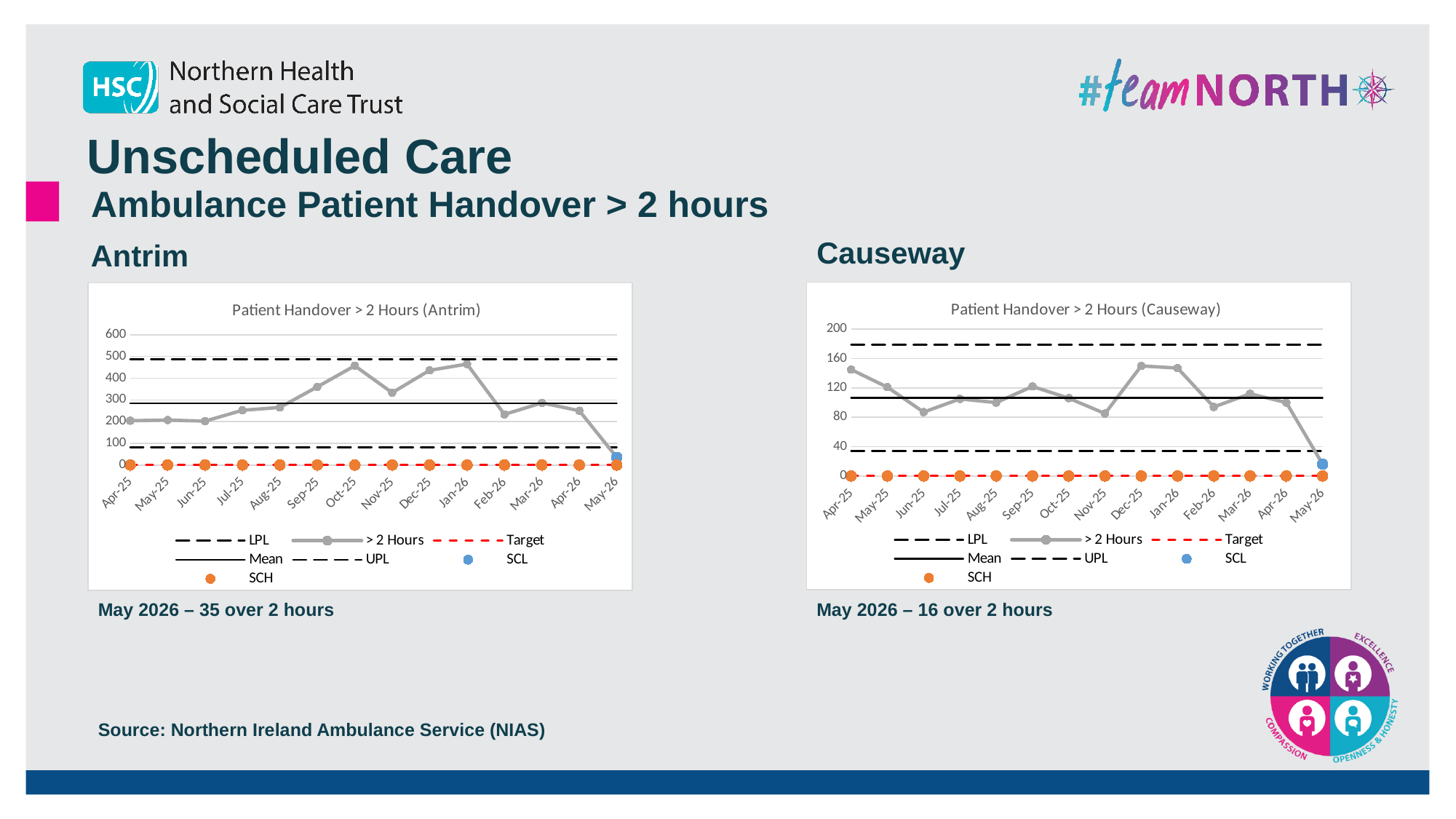
On the Causeway chart, which month has the larger > 2 Hours value, Sep-25 or Nov-25? Sep-25 On the Antrim chart, is the > 2 Hours value for Jan-26 greater or less than 400? greater What kind of chart is the Antrim chart? line chart On the Causeway chart, is the > 2 Hours value for Nov-25 greater or less than 120? less On the Antrim chart, does the > 2 Hours line rise or fall from Jan-26 to May-26? fall On the Antrim chart, which month has the larger > 2 Hours value, Jan-26 or Feb-26? Jan-26 On the Antrim chart, how many months are plotted along the x axis? 14 On the Causeway chart, which month has the lowest > 2 Hours value? May-26 On the Antrim chart, which month has the lowest > 2 Hours value? May-26 On the Antrim chart, what is the > 2 Hours value for May-26? 35 On the Causeway chart, what is the > 2 Hours value for May-26? 16 How many series does the legend of the Causeway chart list? 7